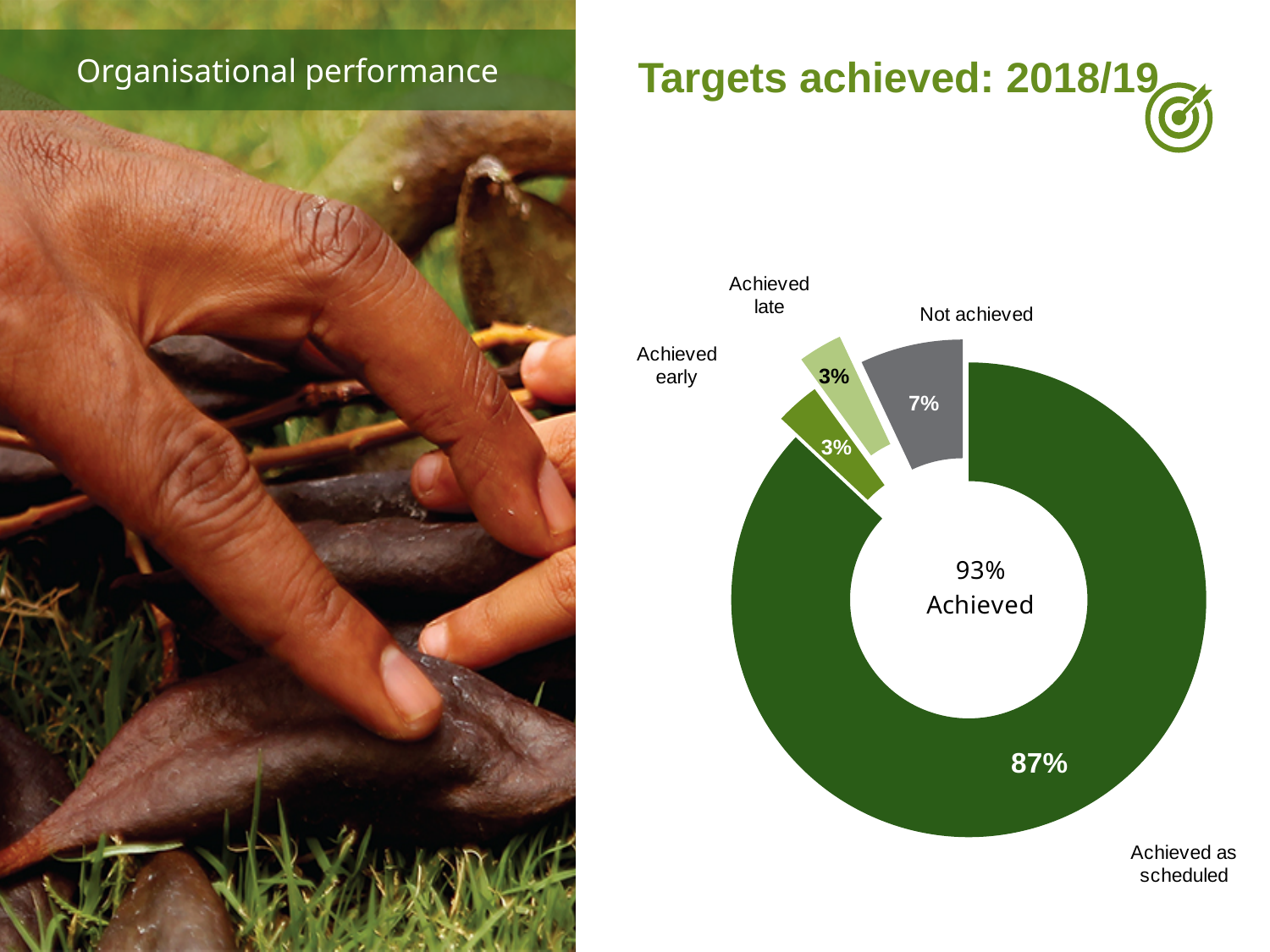
What percentage of targets were not achieved? 7% What percentage of targets were achieved late? 3% What text is shown in the centre of the doughnut chart? 93% Achieved What percentage of targets were achieved as scheduled? 87% What percentage of targets were achieved early? 3% What kind of chart is shown on the slide? Doughnut chart Which is larger, the share for Not achieved or the share for Achieved early? Not achieved How many categories are shown in the chart? 4 What is the difference between the Achieved as scheduled share and the Not achieved share? 80% Which category has the largest share of the chart? Achieved as scheduled What is the title of the chart? Targets achieved: 2018/19 What is the combined share of Achieved early and Achieved late? 6%